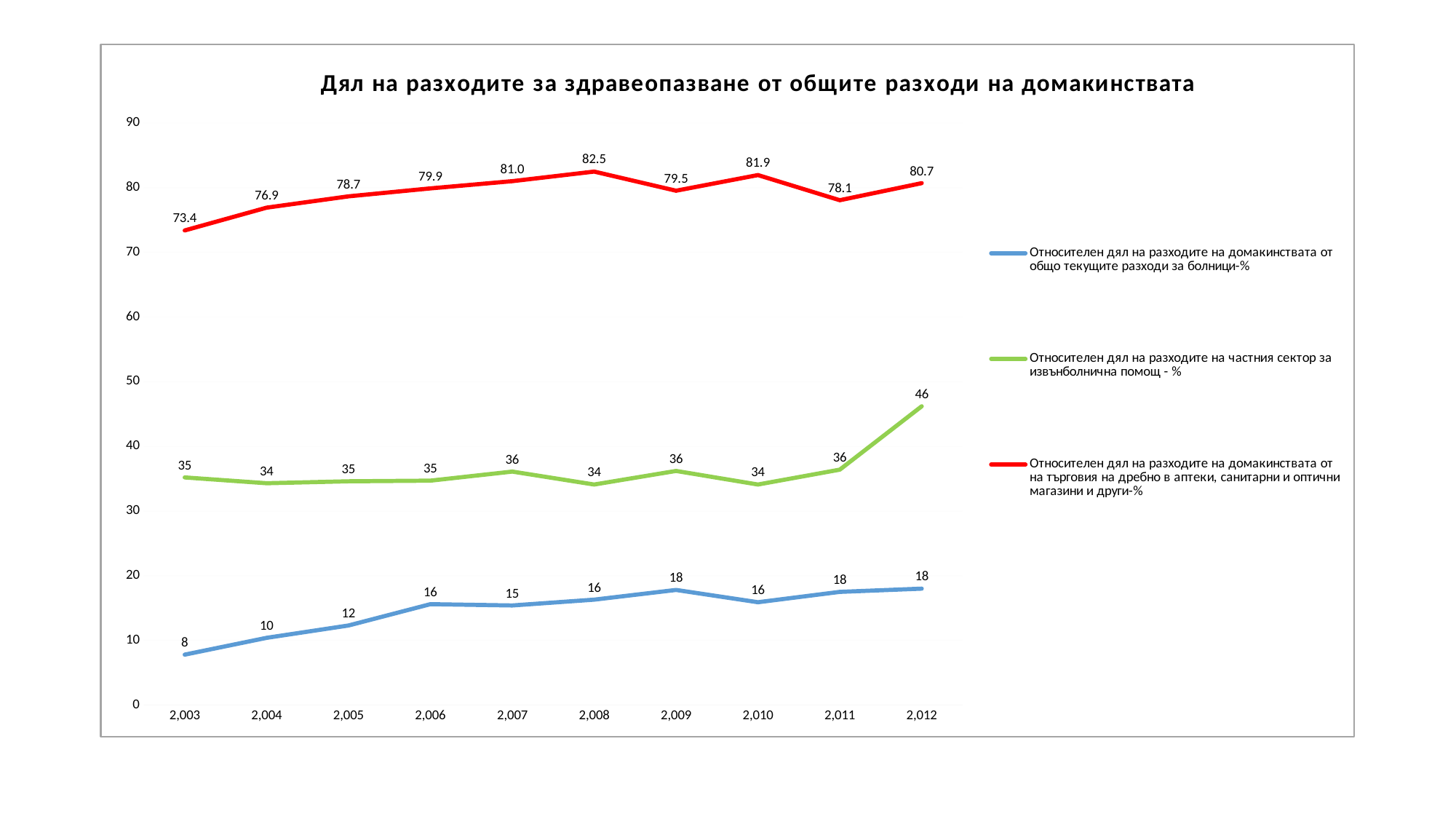
What is the value of the red series (retail trade in pharmacies, sanitary and optical shops) in 2003? 73.4 What is the difference between the red series values in 2008 and 2003? 9.1 Which series has the larger value in 2012, the green series or the blue series? the green series How many years are plotted along the x axis? 10 How many series does the legend list? 3 What is the value of the blue series (hospitals) in 2006? 16 What is the value of the green series (private sector outpatient care) in 2012? 46 Does the blue series (hospitals) generally rise or fall from 2003 to 2012? rise In which year does the red series reach its highest value? 2008 What type of chart is shown on the slide? line chart In which year is the blue series (hospitals) at its lowest value? 2003 What is the title of the chart? Дял на разходите за здравеопазване от общите разходи на домакинствата